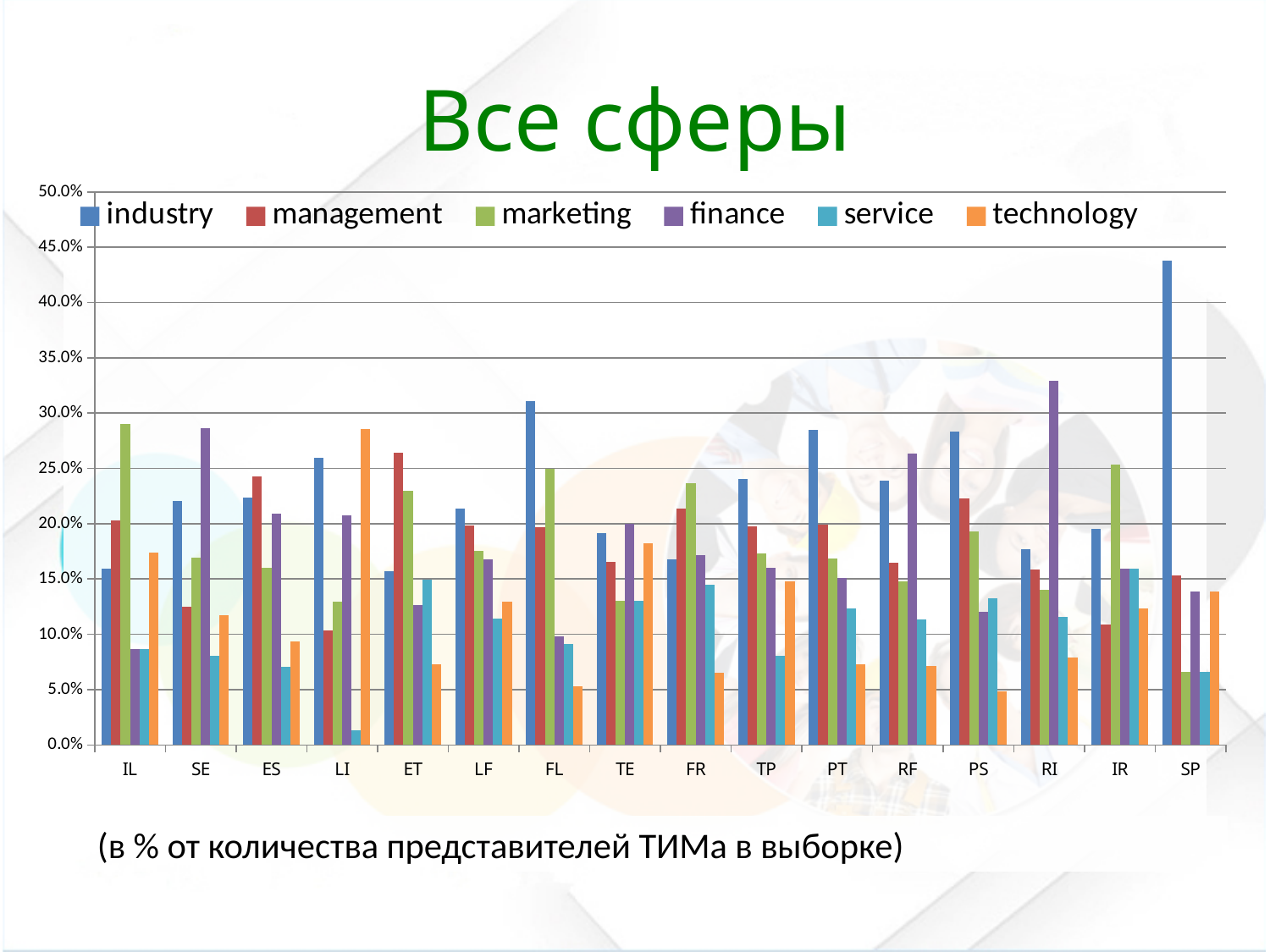
Is the industry value for SP greater or less than 40.0%? greater Which category has the highest value for the technology series? LI Which category has the highest value for the finance series? RI What kind of chart is shown on the slide? bar chart How many series does the legend list? 6 For IL, which is larger: the marketing value or the industry value? marketing Is the finance value for RI greater or less than 30.0%? greater Is the service value for LI greater or less than 5.0%? less Which category has the highest value for the industry series? SP What is the title of the chart? Все сферы Which category has the lowest value for the service series? LI How many categories are shown along the x axis? 16